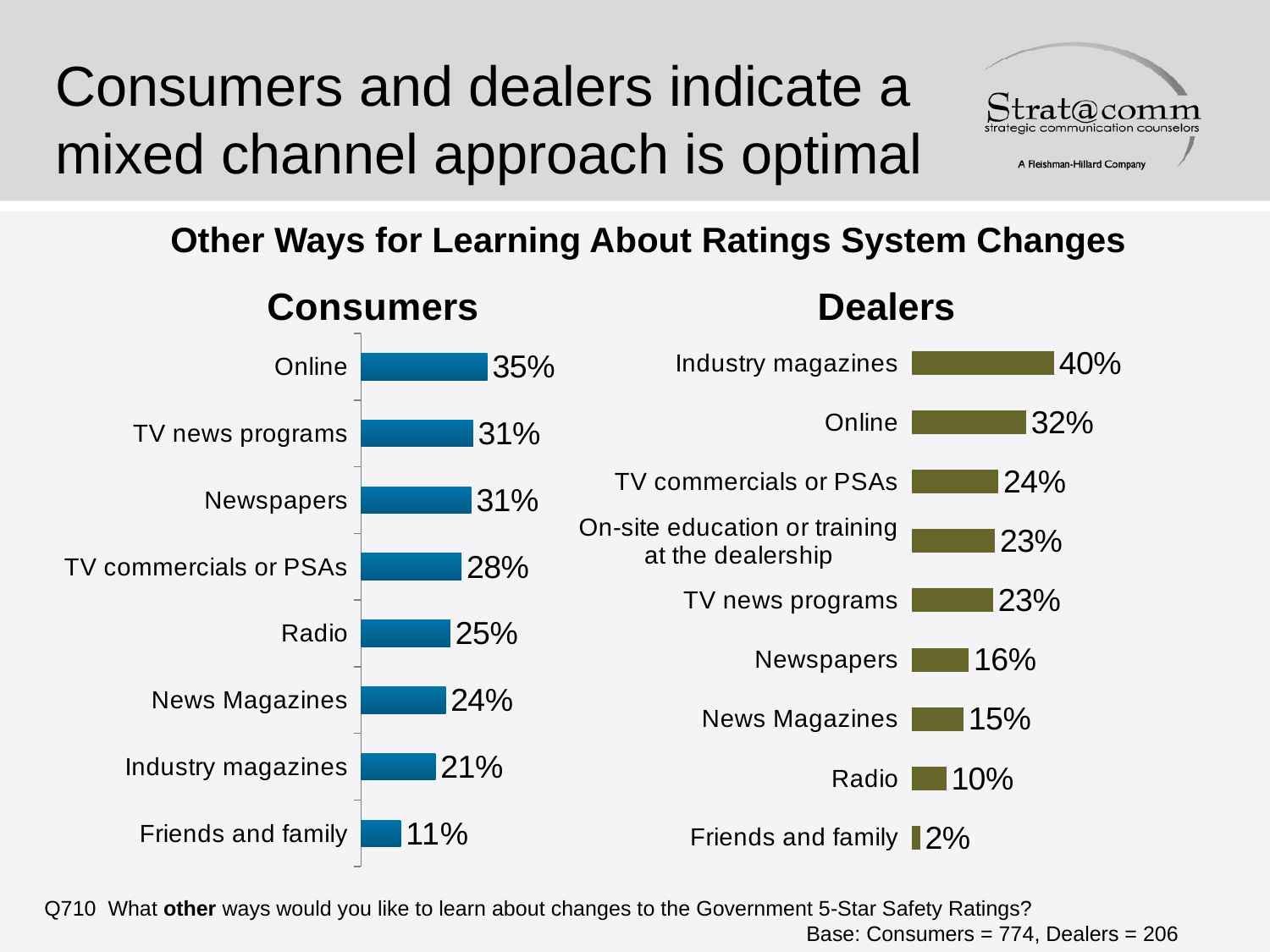
How many categories are shown in the Consumers chart? 8 How many categories are shown in the Dealers chart? 9 In the Dealers chart, what is the value for On-site education or training at the dealership? 23% In the Consumers chart, which category has the lowest value? Friends and family In the Consumers chart, what is the value for Online? 35% Which is larger: Industry magazines in the Consumers chart or Industry magazines in the Dealers chart? Dealers In the Dealers chart, which category has the highest value? Industry magazines In the Dealers chart, what is the value for Industry magazines? 40% What kind of chart is the Dealers chart? Bar chart In the Dealers chart, what is the difference between Online and Radio? 22% What is the overall title above the two charts? Other Ways for Learning About Ratings System Changes In the Consumers chart, what is the difference between Online and Friends and family? 24%